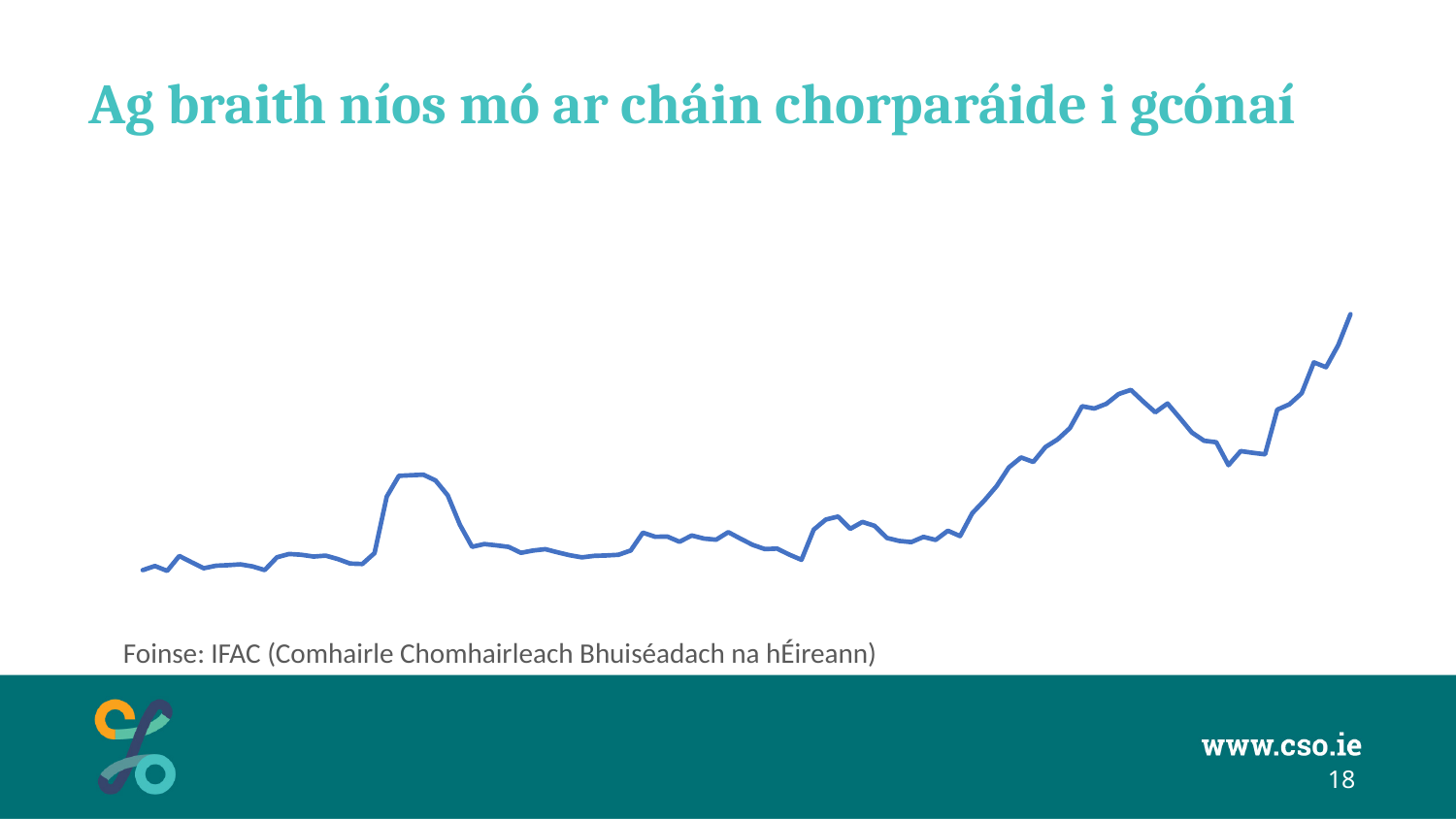
How many lines (series) are plotted in the chart? 1 What is the title of the slide containing the chart? Ag braith níos mó ar cháin chorparáide i gcónaí What colour is the line in the chart? Blue Overall, do the values in the line chart rise or fall from left to right? Rise What kind of chart is shown on the slide? Line chart Is the line at the right-hand end of the chart higher or lower than at the left-hand end? Higher